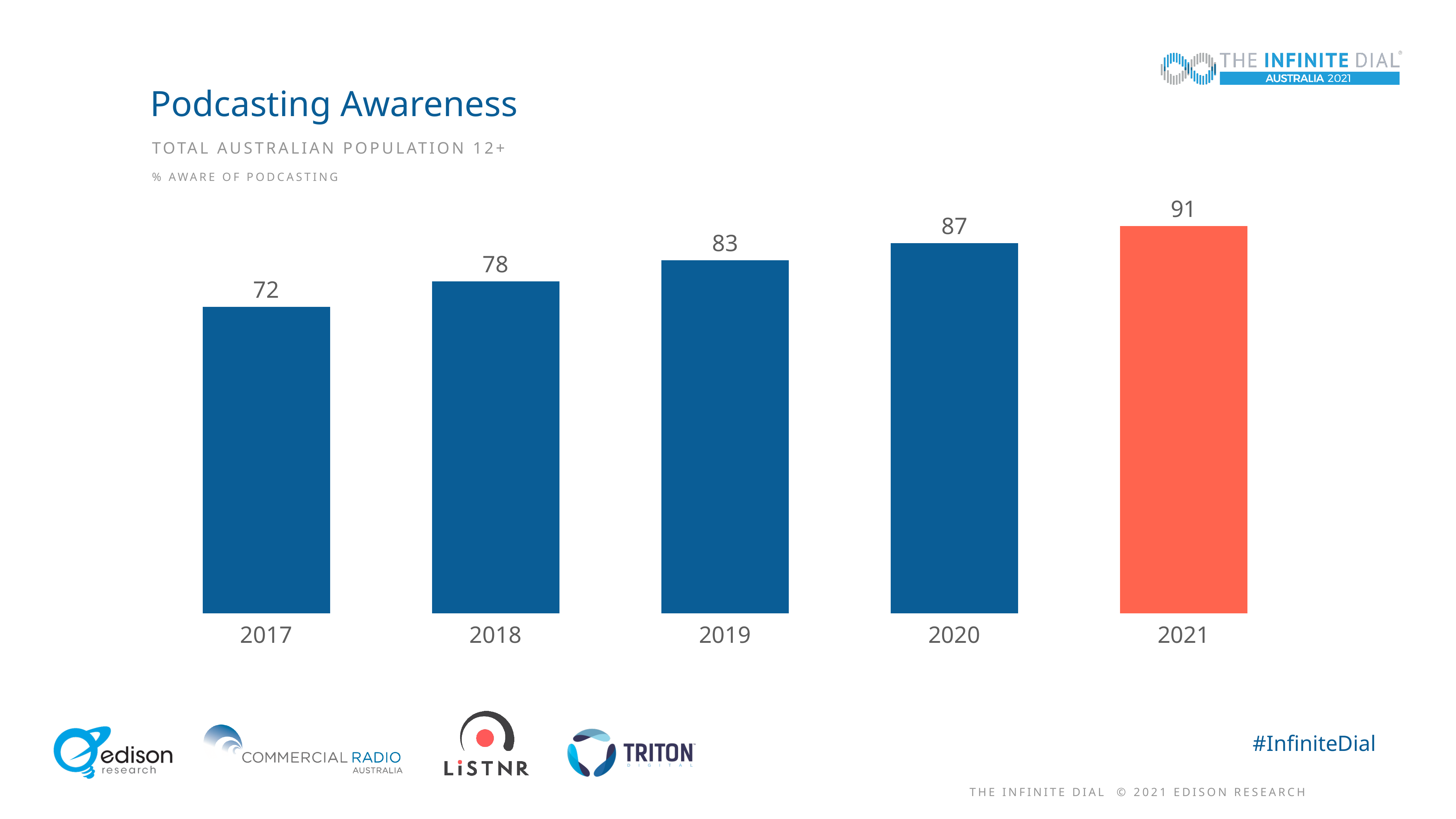
What kind of chart is this? Bar chart Which is larger, the value for 2018 or the value for 2020? 2020 Do the values rise or fall from 2017 to 2021? Rise What is the difference between the values for 2021 and 2017? 19 What is the difference between the values for 2020 and 2019? 4 Which year has the highest value? 2021 What is the value for 2021? 91 What is the value for 2017? 72 Which year's bar is coloured differently from the others? 2021 Which year has the lowest value? 2017 How many years are shown on the chart? 5 What is the value for 2019? 83